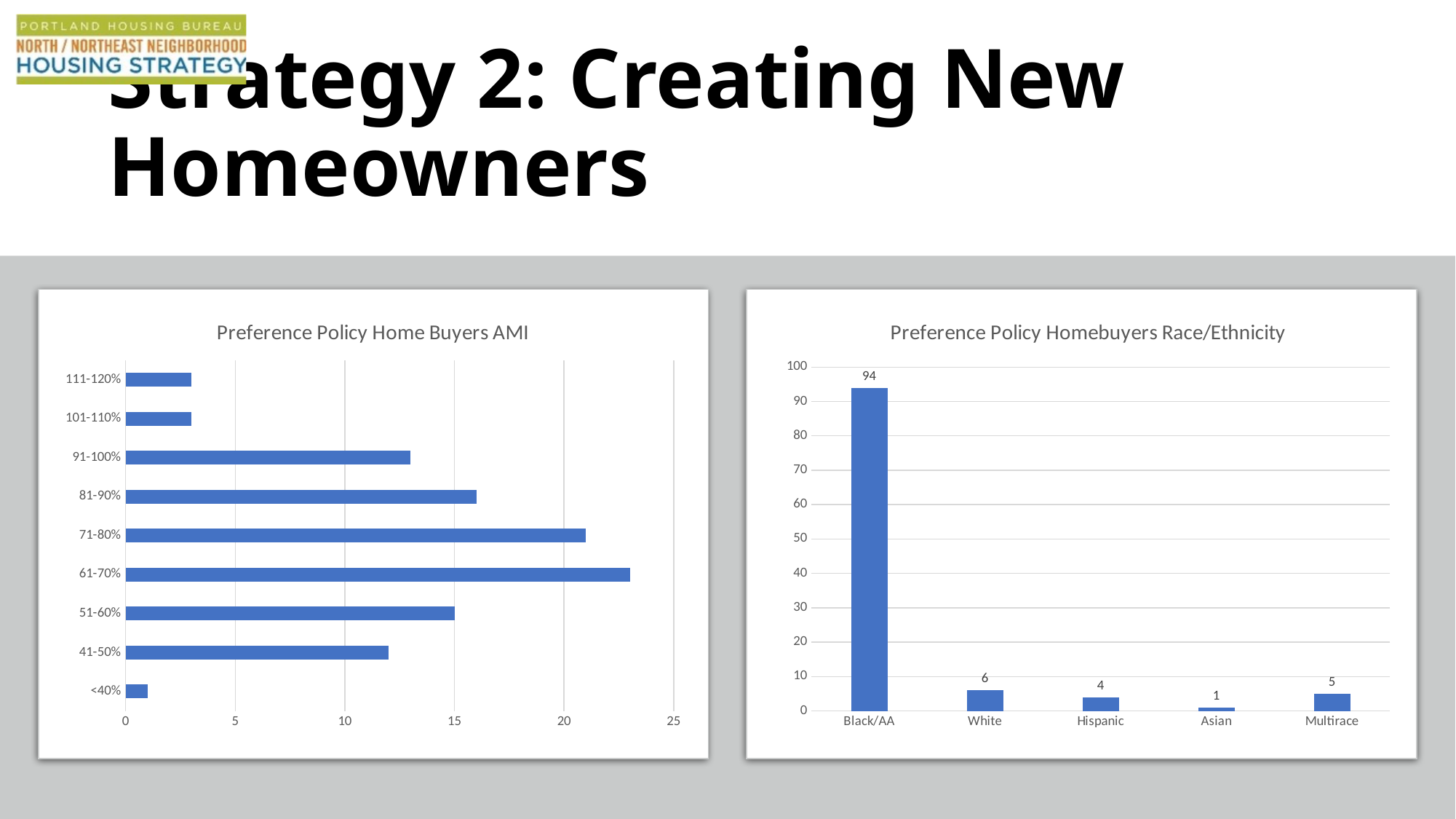
In the Preference Policy Homebuyers Race/Ethnicity chart, what is the value for Hispanic? 4 In the Preference Policy Home Buyers AMI chart, which category has the lowest value? <40% In the Preference Policy Home Buyers AMI chart, which is larger, the value for 81-90% or the value for 41-50%? 81-90% What kind of chart is the Preference Policy Home Buyers AMI chart? Bar chart In the Preference Policy Homebuyers Race/Ethnicity chart, what is the difference between the values for White and Multirace? 1 In the Preference Policy Homebuyers Race/Ethnicity chart, how many categories are shown on the x axis? 5 In the Preference Policy Homebuyers Race/Ethnicity chart, what is the value for Black/AA? 94 In the Preference Policy Home Buyers AMI chart, which category has the highest value? 61-70% In the Preference Policy Homebuyers Race/Ethnicity chart, what is the difference between the values for Black/AA and White? 88 In the Preference Policy Home Buyers AMI chart, is the value for 71-80% greater or less than 20? greater In the Preference Policy Home Buyers AMI chart, is the value for 91-100% greater or less than 15? less In the Preference Policy Homebuyers Race/Ethnicity chart, which category has the lowest value? Asian